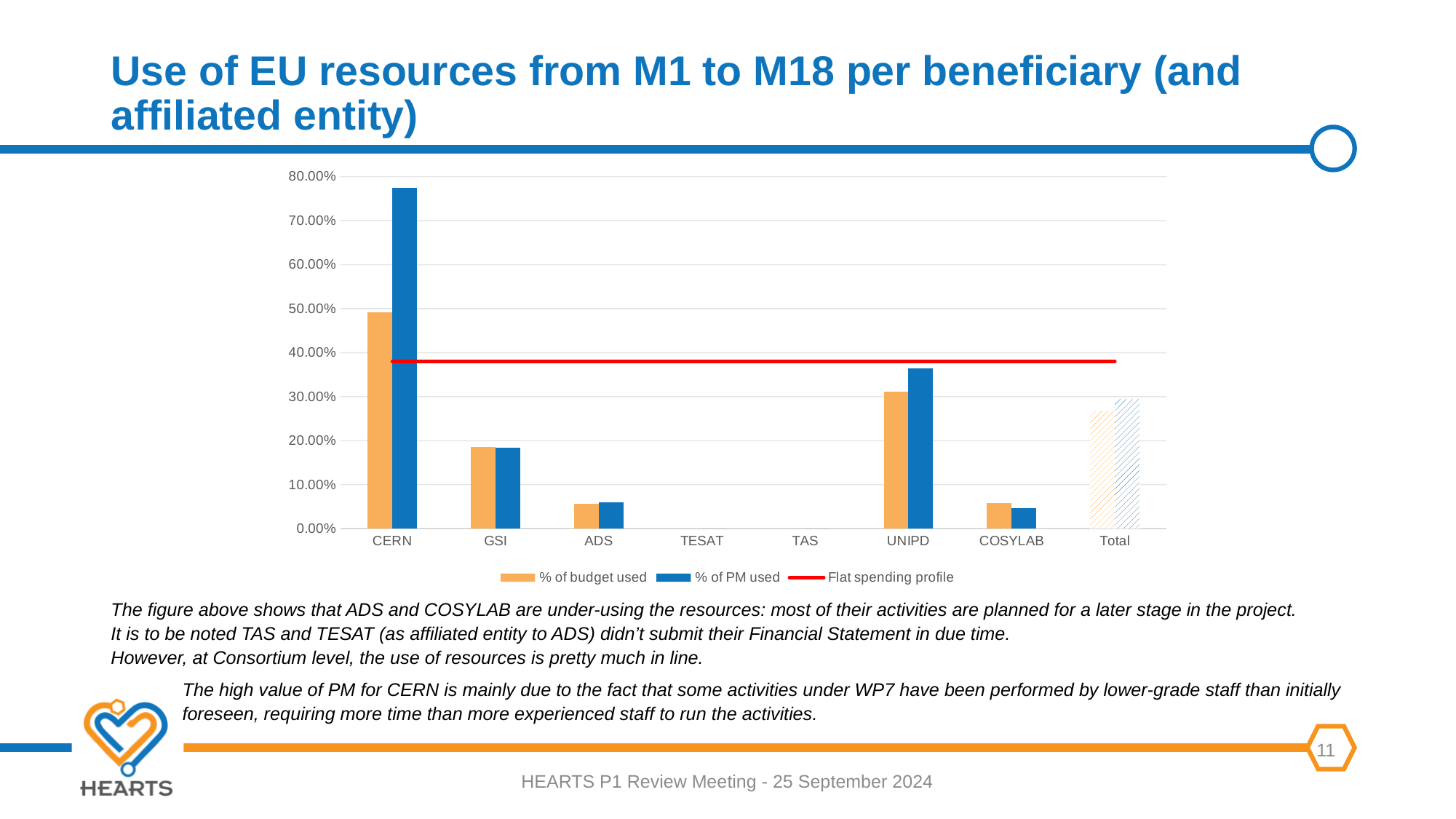
Is the % of PM used for CERN greater or less than 70.00%? greater Is the % of PM used for UNIPD greater or less than 40.00%? less How many series does the chart legend list? 3 For CERN, which is larger: % of budget used or % of PM used? % of PM used How many categories are shown on the x axis of the chart? 8 For UNIPD, which is larger: % of budget used or % of PM used? % of PM used Which category has the highest % of budget used? CERN What does the red horizontal line in the chart represent, according to the legend? Flat spending profile What kind of chart is shown on the slide? Combination bar and line chart Is the % of budget used for CERN greater or less than 40.00%? greater Which category has the highest % of PM used? CERN